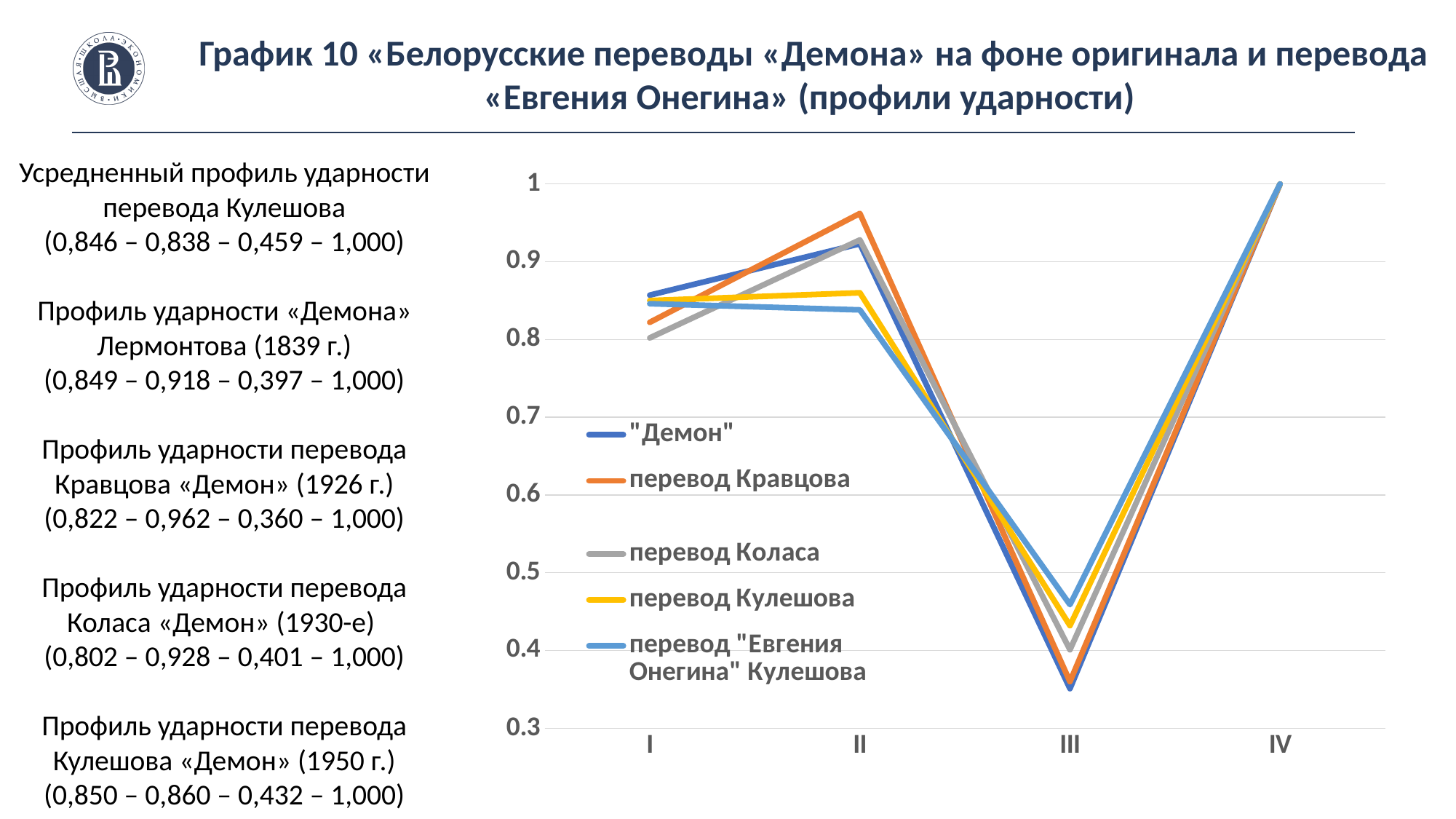
Which series has the lowest value at position III? "Демон" Which is larger at position I: the value for "Демон" or the value for перевод Коласа? "Демон" Do the values for all series rise or fall from position II to position III? fall According to the text on the slide, what is the value of перевод Кравцова at position II? 0,962 What value do all series reach at position IV? 1,000 How many points are plotted along the x axis for each series? 4 Is the value for перевод Кулешова at position III greater or less than 0.5? less What kind of chart is shown on the slide? line chart How many series does the legend list? 5 Which series has the highest value at position II? перевод Кравцова Which series has the highest value at position III? перевод "Евгения Онегина" Кулешова According to the text on the slide, what is the value of перевод Коласа at position I? 0,802